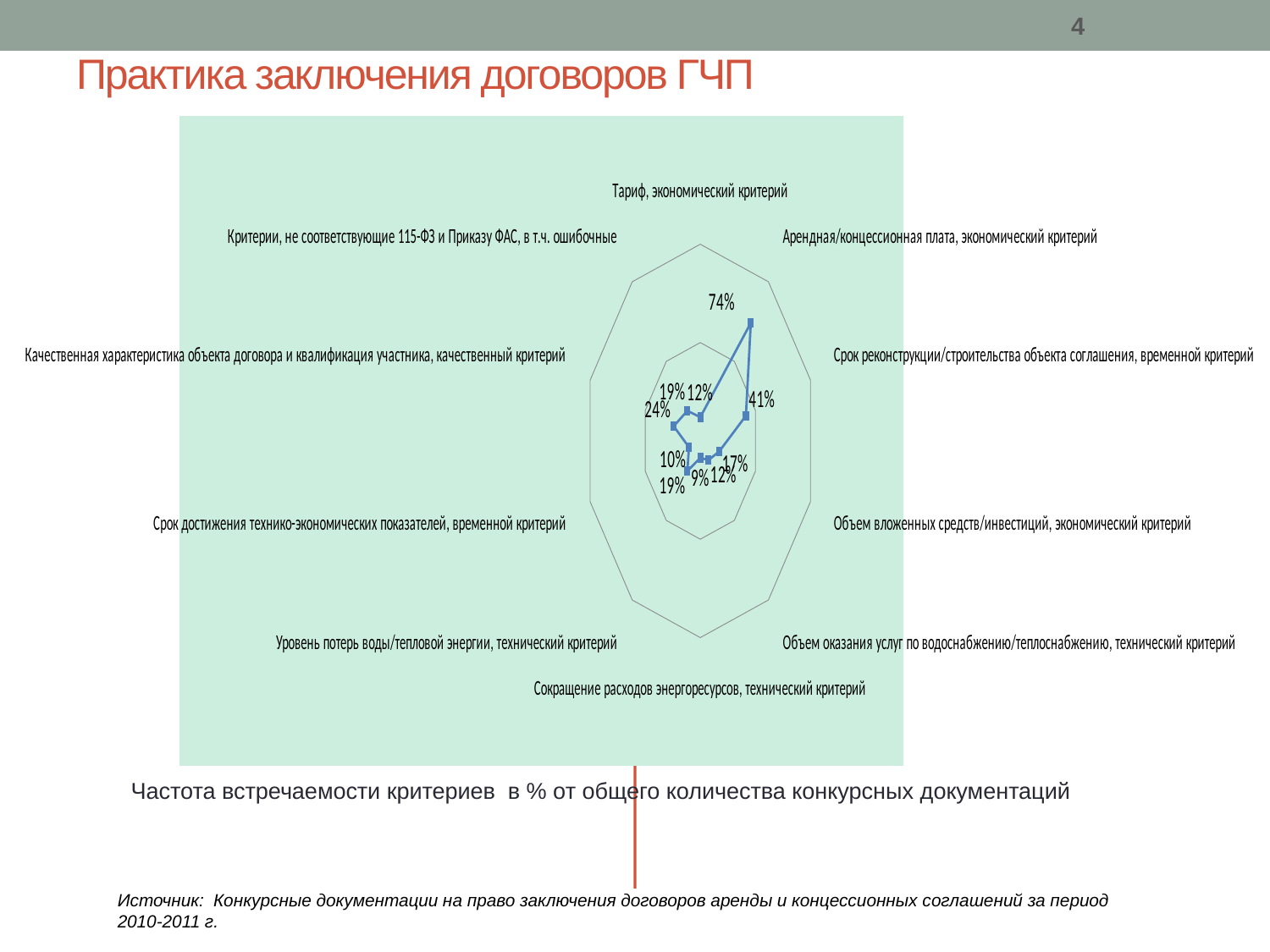
What is the value for 'Срок реконструкции/строительства объекта соглашения, временной критерий'? 41% Which is larger: the value for 'Арендная/концессионная плата, экономический критерий' or for 'Срок реконструкции/строительства объекта соглашения, временной критерий'? Арендная/концессионная плата, экономический критерий What is the difference between the highest value (74%) and the second highest value (41%) on the chart? 33 percentage points Which criterion has the highest frequency on the radar chart? Арендная/концессионная плата, экономический критерий What is the lowest value shown on the radar chart? 9% What is the highest value shown on the radar chart? 74% What kind of chart is shown on the slide? radar chart What is the value for 'Качественная характеристика объекта договора и квалификация участника, качественный критерий'? 24% What period does the source note say the data covers? 2010-2011 г. How many criteria (categories) are plotted on the radar chart? 10 What is the value for 'Арендная/концессионная плата, экономический критерий'? 74% What does the caption below the chart say the values represent? Частота встречаемости критериев в % от общего количества конкурсных документаций